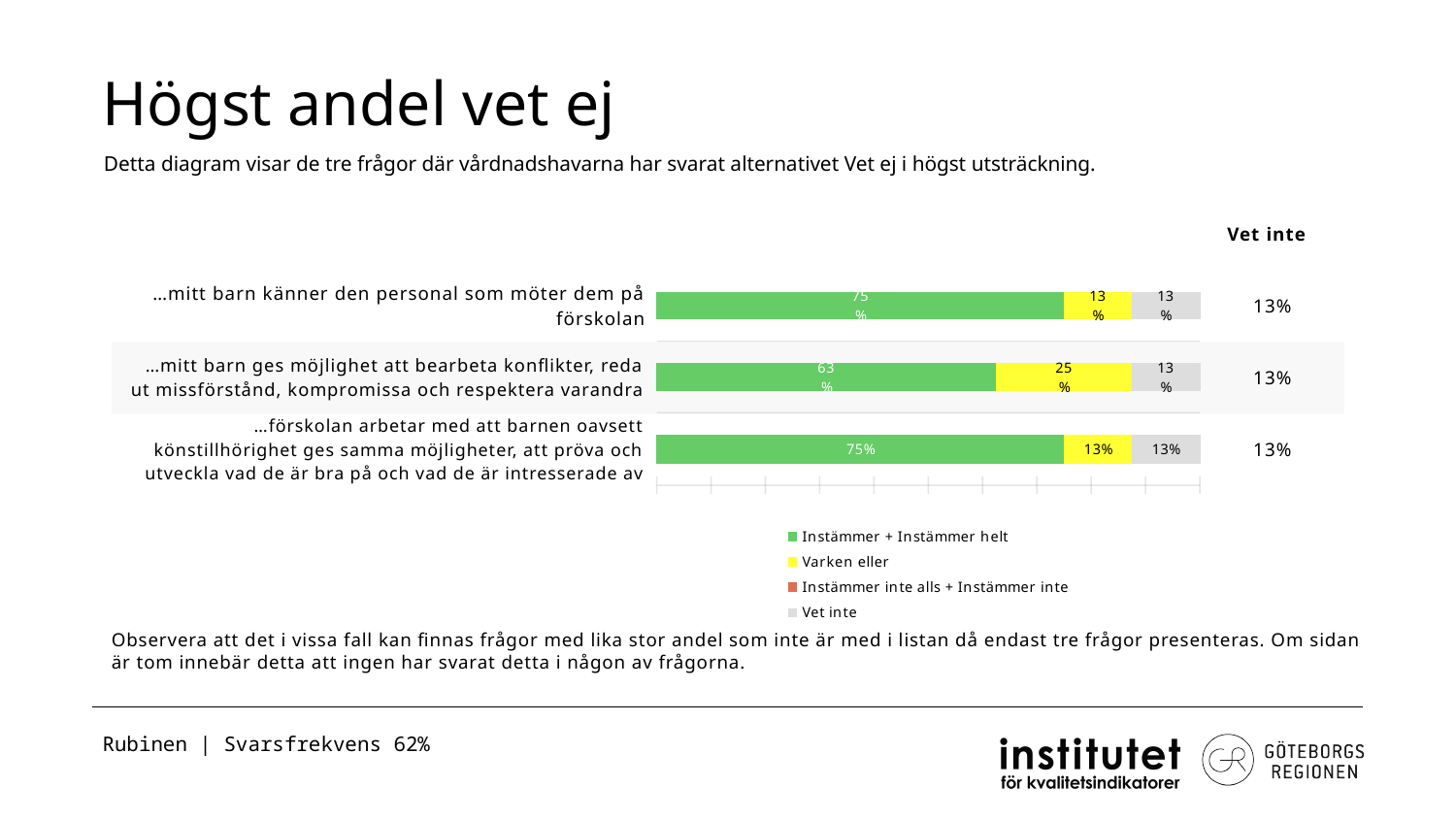
Which category has the lowest 'Instämmer + Instämmer helt' value? …mitt barn ges möjlighet att bearbeta konflikter, reda ut missförstånd, kompromissa och respektera varandra What is the 'Instämmer + Instämmer helt' value for '…mitt barn ges möjlighet att bearbeta konflikter, reda ut missförstånd, kompromissa och respektera varandra'? 63% How many series does the legend list? 4 How many categories (questions) are plotted in the chart? 3 Which category has the highest 'Varken eller' value? …mitt barn ges möjlighet att bearbeta konflikter, reda ut missförstånd, kompromissa och respektera varandra Which is larger: the 'Instämmer + Instämmer helt' value for '…mitt barn känner den personal som möter dem på förskolan' or for '…mitt barn ges möjlighet att bearbeta konflikter…'? …mitt barn känner den personal som möter dem på förskolan What is the 'Instämmer + Instämmer helt' value for '…mitt barn känner den personal som möter dem på förskolan'? 75% What is the 'Vet inte' value for '…förskolan arbetar med att barnen oavsett könstillhörighet ges samma möjligheter, att pröva och utveckla vad de är bra på och vad de är intresserade av'? 13% What is the 'Varken eller' value for '…mitt barn ges möjlighet att bearbeta konflikter, reda ut missförstånd, kompromissa och respektera varandra'? 25% What kind of chart is shown on the slide? stacked bar chart What is the title of the slide containing the chart? Högst andel vet ej What is the difference between the 'Varken eller' value for '…mitt barn ges möjlighet att bearbeta konflikter…' and the 'Varken eller' value for '…mitt barn känner den personal som möter dem på förskolan'? 12%